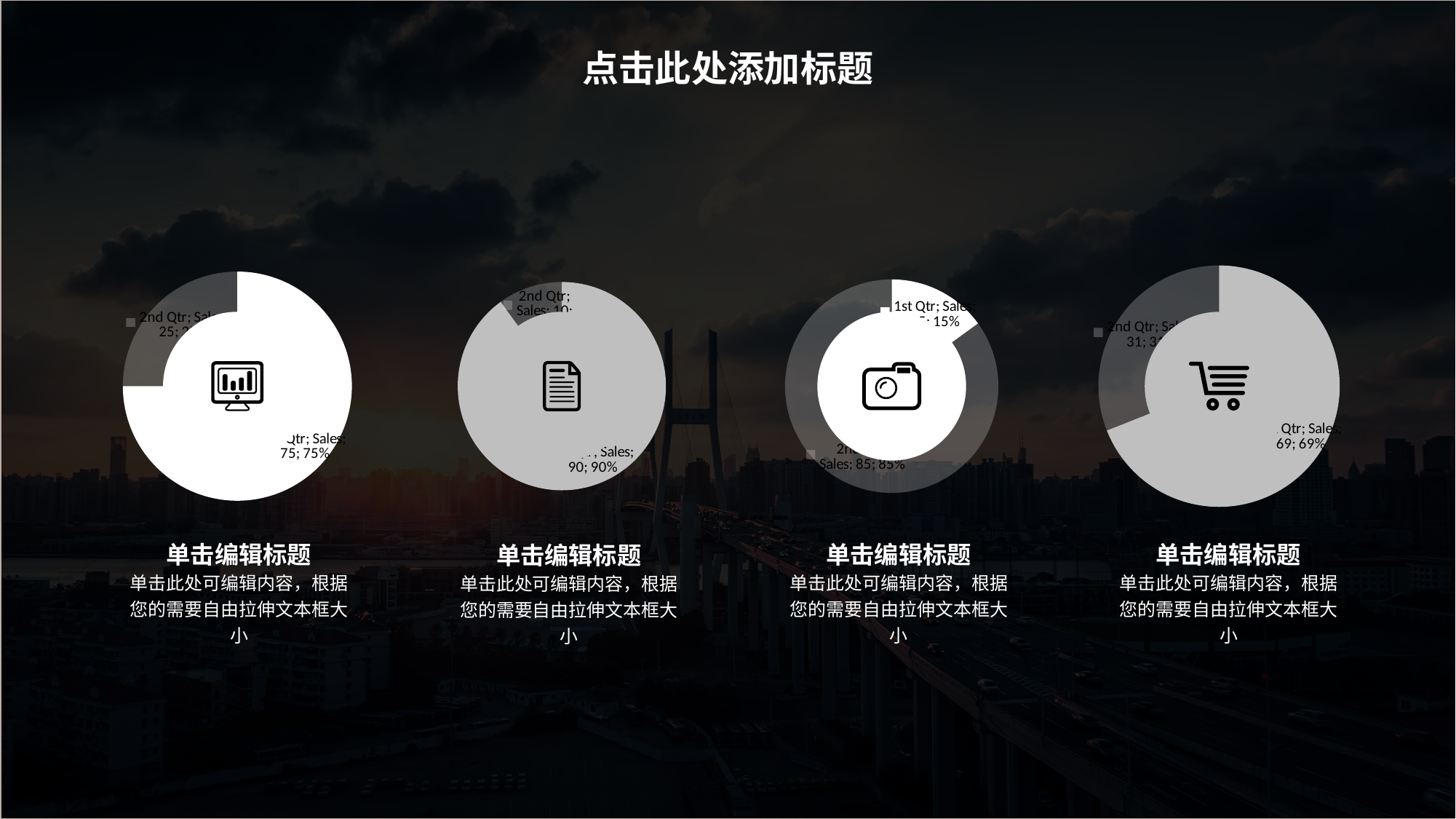
In the second pie chart from the left, what is the Sales value labelled for the largest slice? 90 In the rightmost pie chart, what percentage is shown for the largest slice? 69% In the rightmost pie chart, what is the Sales value labelled for 2nd Qtr? 31 How many pie charts are shown on the slide? 4 In the leftmost pie chart, what percentage is shown for the largest slice? 75% In the third pie chart from the left, what percentage is shown for 1st Qtr? 15% In the third pie chart from the left, what is the Sales value labelled for 2nd Qtr? 85 What kind of chart is the leftmost chart on the slide? pie chart In the leftmost pie chart, what is the Sales value labelled for 2nd Qtr? 25 In the third pie chart from the left, which slice is larger, 1st Qtr or 2nd Qtr? 2nd Qtr How many slices does the leftmost pie chart have? 2